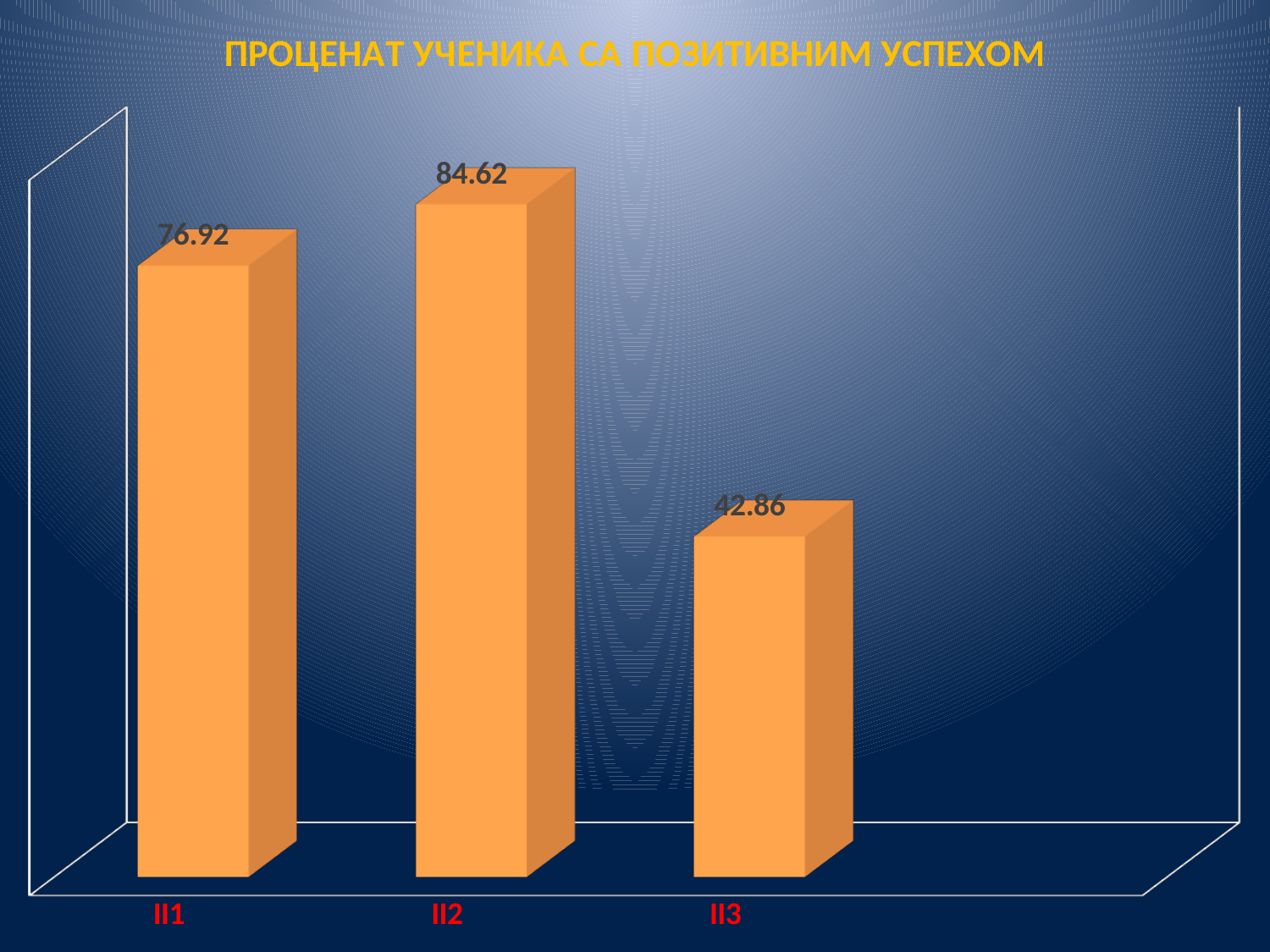
What kind of chart is shown on the slide? bar chart What is the difference between the values for II2 and II1? 7.70 What is the difference between the values for II1 and II3? 34.06 Which is larger, the value for II1 or the value for II3? II1 What is the value for II2? 84.62 What colour are the bars in the chart? orange Which category has the lowest value? II3 What is the value for II3? 42.86 What is the title of the chart? ПРОЦЕНАТ УЧЕНИКА СА ПОЗИТИВНИМ УСПЕХОМ Which category has the highest value? II2 How many categories are shown in the chart? 3 What is the value for II1? 76.92